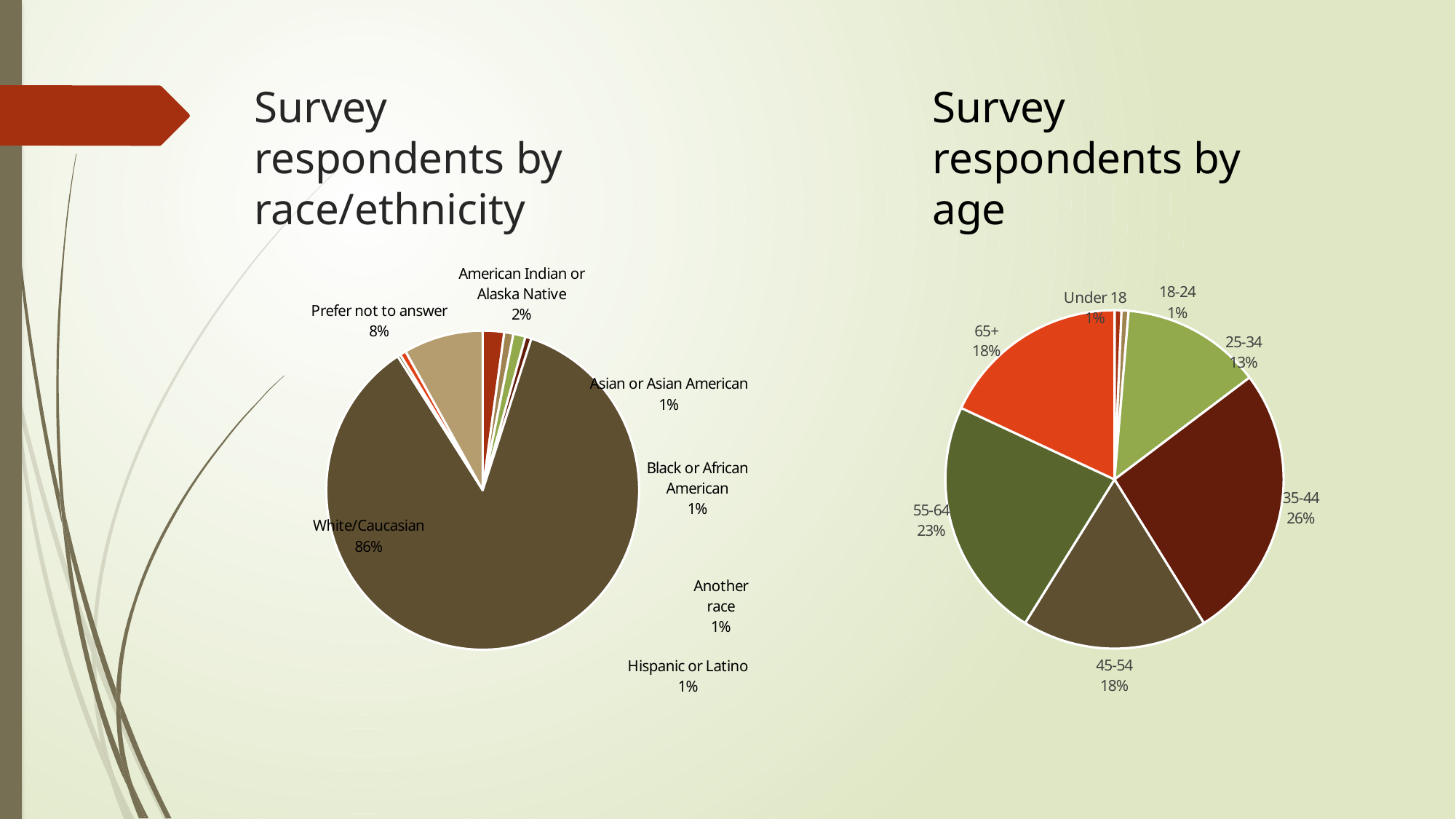
In the 'Survey respondents by race/ethnicity' chart, which category has the largest share? White/Caucasian What kind of chart is 'Survey respondents by race/ethnicity'? Pie chart In the 'Survey respondents by race/ethnicity' chart, what share of respondents are American Indian or Alaska Native? 2% In the 'Survey respondents by age' chart, which is larger, the share for 55-64 or the share for 45-54? 55-64 In the 'Survey respondents by age' chart, which age group has the largest share? 35-44 In the 'Survey respondents by race/ethnicity' chart, what share of respondents chose 'Prefer not to answer'? 8% In the 'Survey respondents by age' chart, what is the difference between the 35-44 share and the 25-34 share? 13% In the 'Survey respondents by age' chart, what share of respondents are aged 55-64? 23% In the 'Survey respondents by age' chart, how many age groups are shown? 7 In the 'Survey respondents by race/ethnicity' chart, what share of respondents are White/Caucasian? 86% In the 'Survey respondents by age' chart, what share of respondents are aged 35-44? 26%